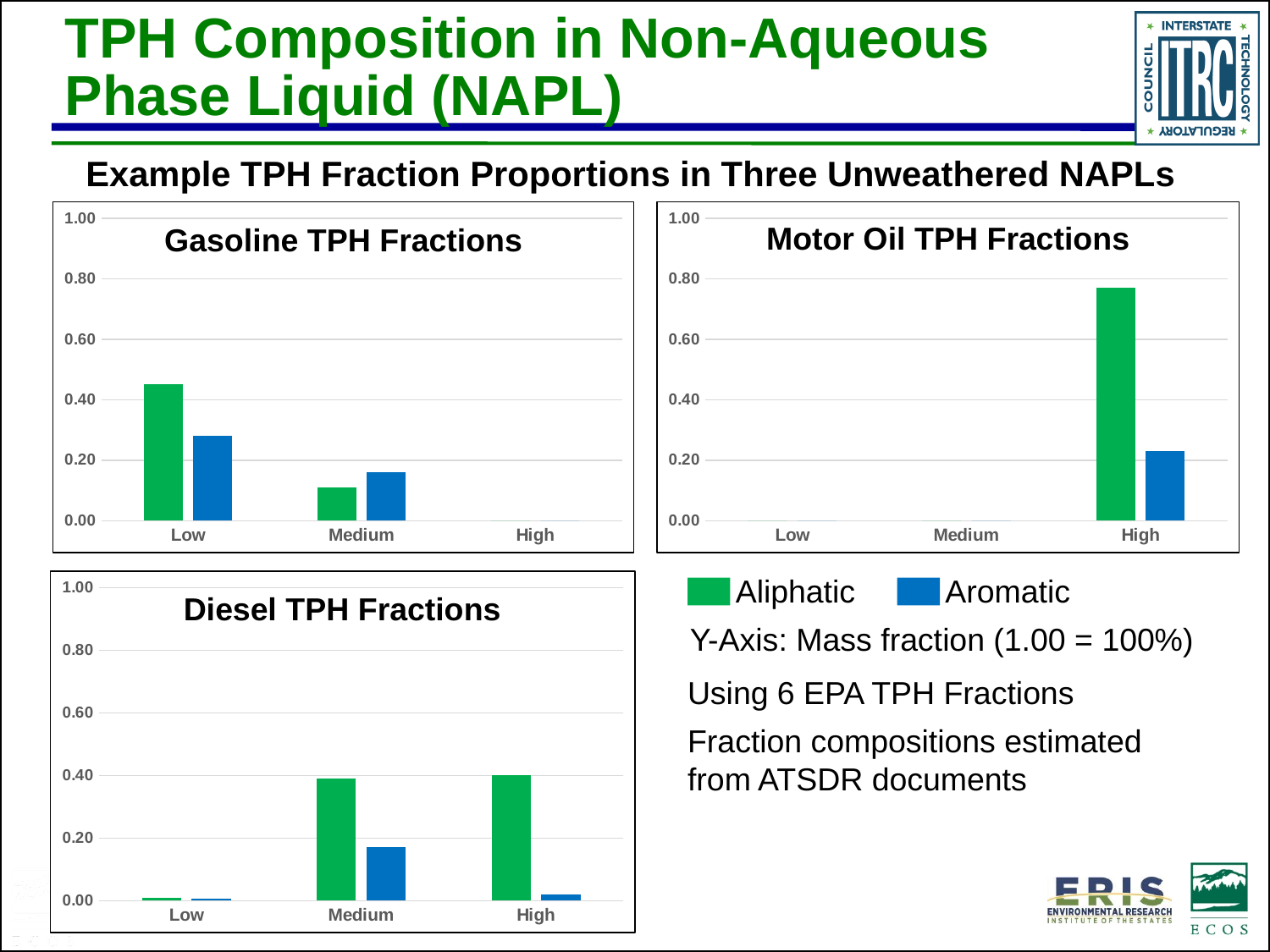
In the Diesel TPH Fractions chart, which category has the lowest Aliphatic value? Low In the Motor Oil TPH Fractions chart, which category has the highest Aliphatic value? High In the Diesel TPH Fractions chart, is the Aromatic value for Medium greater or less than 0.20? less In the Motor Oil TPH Fractions chart, how many categories are on the x axis? 3 In the Gasoline TPH Fractions chart, is the Aromatic value for Medium greater or less than 0.20? less In the Motor Oil TPH Fractions chart, is the Aliphatic value for High greater or less than 0.60? greater Which colour represents the Aromatic series in the charts? blue In the Gasoline TPH Fractions chart, which is larger for Low: the Aliphatic value or the Aromatic value? Aliphatic In the Gasoline TPH Fractions chart, what kind of chart is shown? bar chart How many series does the legend on the slide list? 2 In the Diesel TPH Fractions chart, which is larger for High: the Aliphatic value or the Aromatic value? Aliphatic